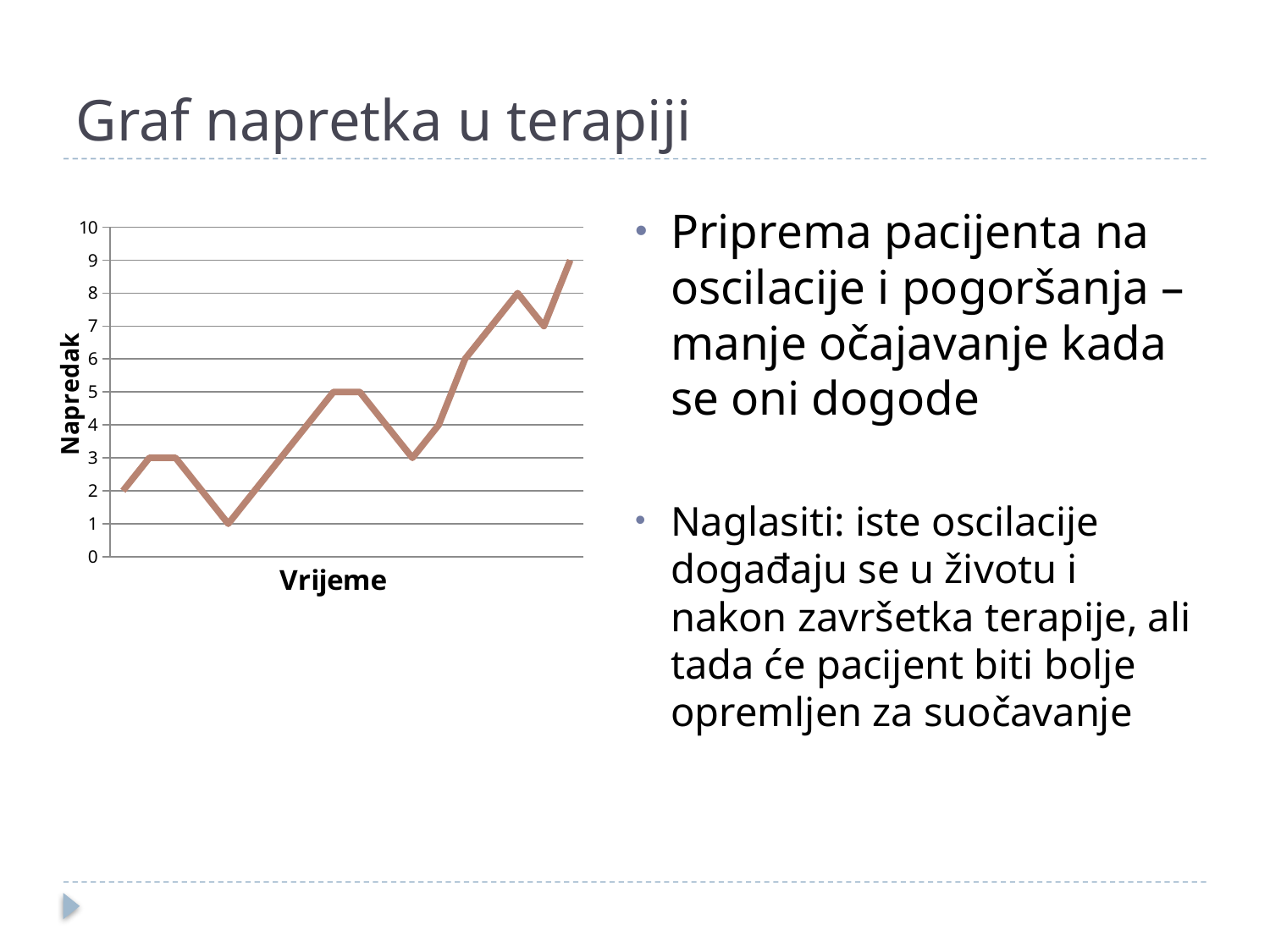
By how much is the value of the last point higher than the value of the first point? 7 What is the title of the horizontal axis of the chart? Vrijeme What is the highest tick value shown on the vertical axis? 10 What is the title of the vertical axis of the chart? Napredak Is the value of the last point of the line greater or less than 5? greater What kind of chart is shown on the slide? line chart What is the highest value the line reaches? 9 What is the value of the first point of the line? 2 What is the lowest value the line reaches? 1 Overall, does the line rise or fall from left to right? rise Which is larger, the value of the first point or the value of the last point of the line? the last point What is the value of the last point of the line? 9